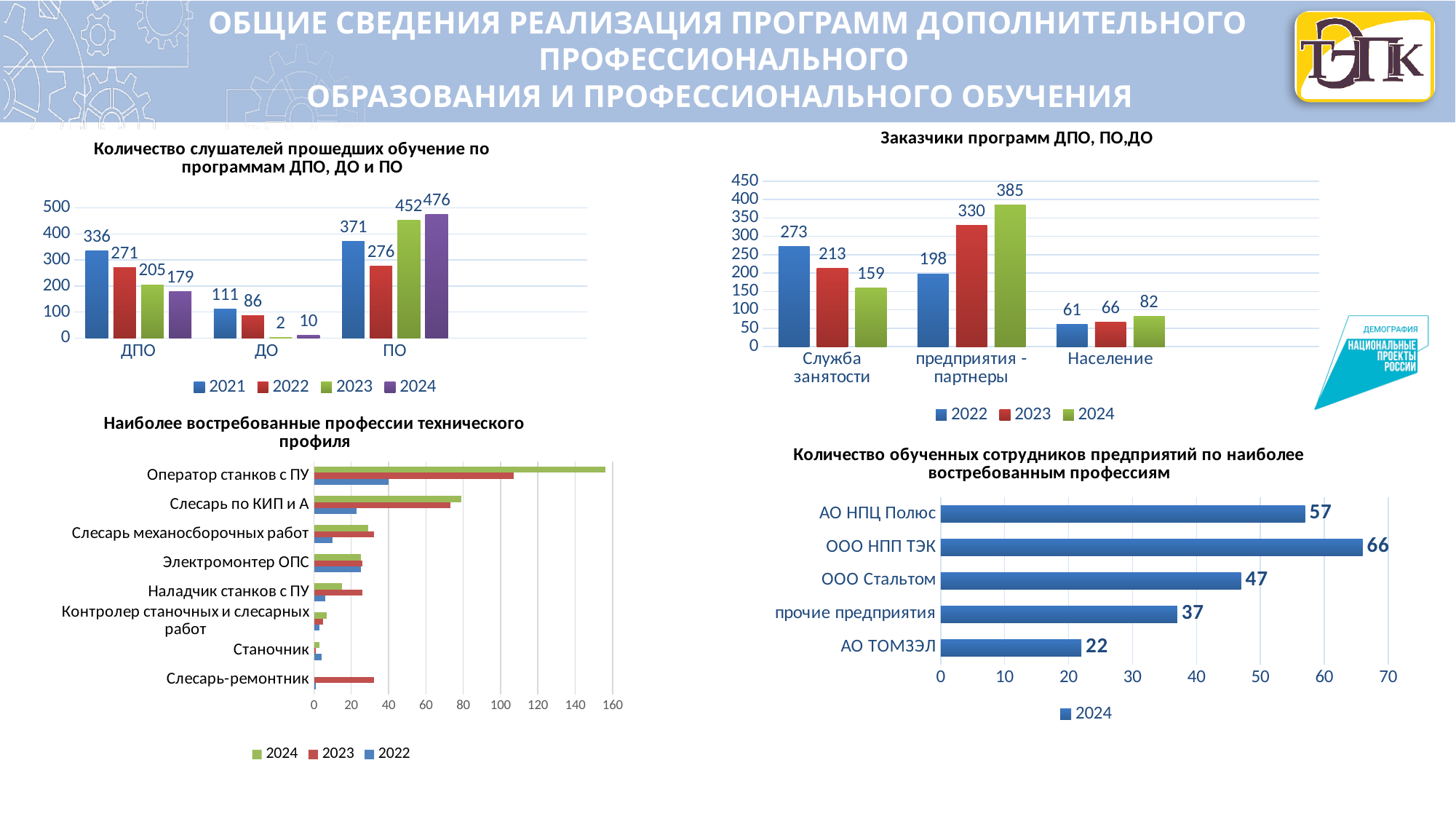
In the chart 'Количество слушателей прошедших обучение по программам ДПО, ДО и ПО', what is the value for ПО in 2024? 476 What kind of chart is 'Количество обученных сотрудников предприятий по наиболее востребованным профессиям'? bar chart In the chart 'Заказчики программ ДПО, ПО,ДО', which is larger: Служба занятости in 2023 or предприятия - партнеры in 2023? предприятия - партнеры In the chart 'Количество слушателей прошедших обучение по программам ДПО, ДО и ПО', what is the value for ДО in 2023? 2 In the chart 'Количество обученных сотрудников предприятий по наиболее востребованным профессиям', which enterprise has the highest value? ООО НПП ТЭК How many categories are shown in the chart 'Наиболее востребованные профессии технического профиля'? 8 In the chart 'Количество слушателей прошедших обучение по программам ДПО, ДО и ПО', what is the difference between the 2021 and 2024 values for ДПО? 157 In the chart 'Заказчики программ ДПО, ПО,ДО', do the values for Служба занятости rise or fall from 2022 to 2024? fall In the chart 'Наиболее востребованные профессии технического профиля', is the 2024 value for Оператор станков с ПУ greater or less than 140? greater In the chart 'Заказчики программ ДПО, ПО,ДО', what is the value for предприятия - партнеры in 2024? 385 In the chart 'Заказчики программ ДПО, ПО,ДО', which category has the lowest value in 2022? Население How many series does the legend list in the chart 'Количество слушателей прошедших обучение по программам ДПО, ДО и ПО'? 4